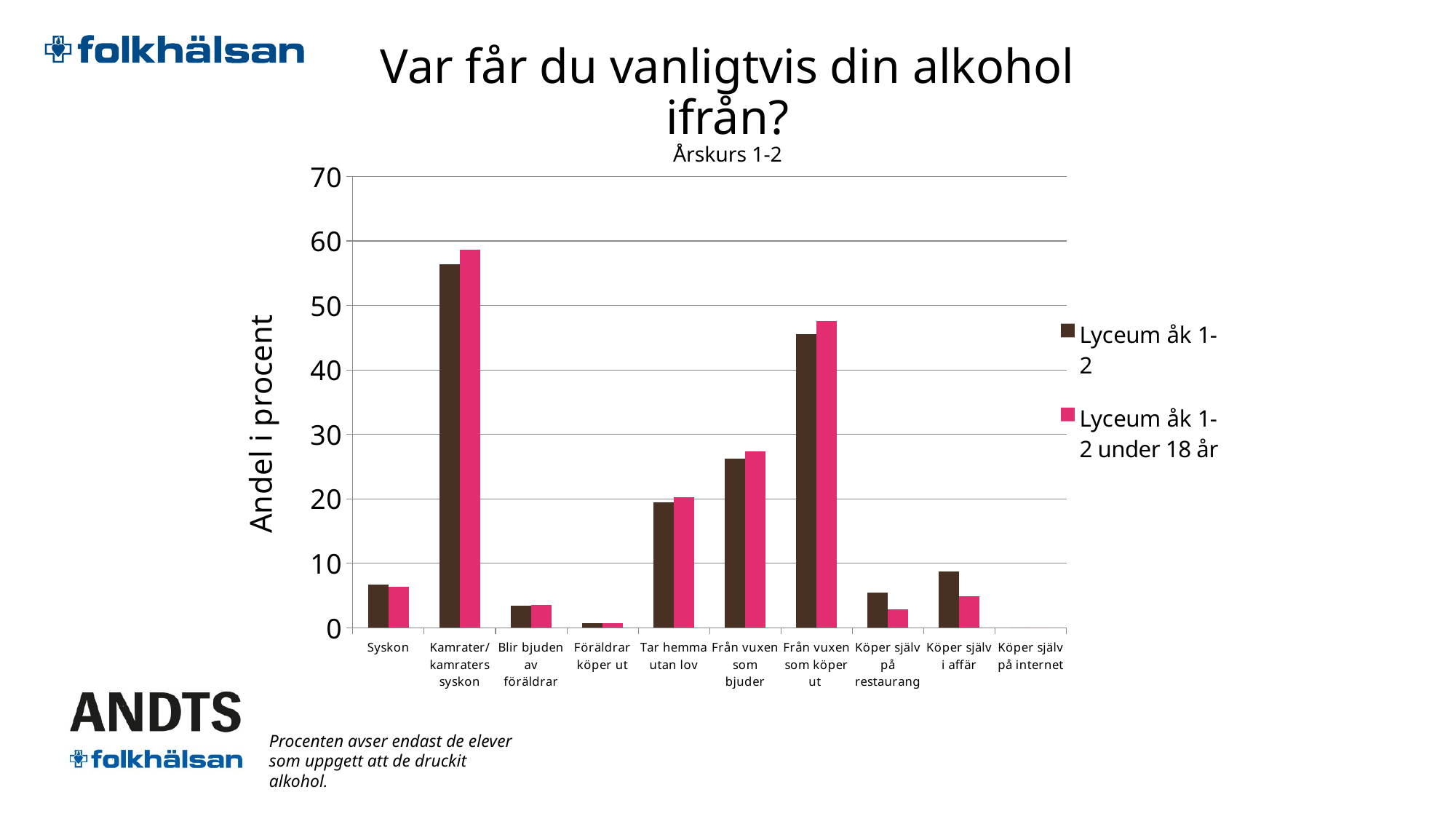
Is the Lyceum åk 1-2 value for Kamrater/kamraters syskon greater or less than 50? greater What is the label of the y axis? Andel i procent Is the Lyceum åk 1-2 under 18 år value for Från vuxen som köper ut greater or less than 50? less What kind of chart is shown on the slide? bar chart Which category has the highest value for the Lyceum åk 1-2 series? Kamrater/kamraters syskon Which category has the highest value for the Lyceum åk 1-2 under 18 år series? Kamrater/kamraters syskon How many series does the legend list? 2 How many categories are shown on the x axis? 10 For Köper själv i affär, which series has the larger value, Lyceum åk 1-2 or Lyceum åk 1-2 under 18 år? Lyceum åk 1-2 Is the Lyceum åk 1-2 under 18 år value for Från vuxen som bjuder greater or less than 20? greater Which category has the lowest value for the Lyceum åk 1-2 series? Köper själv på internet